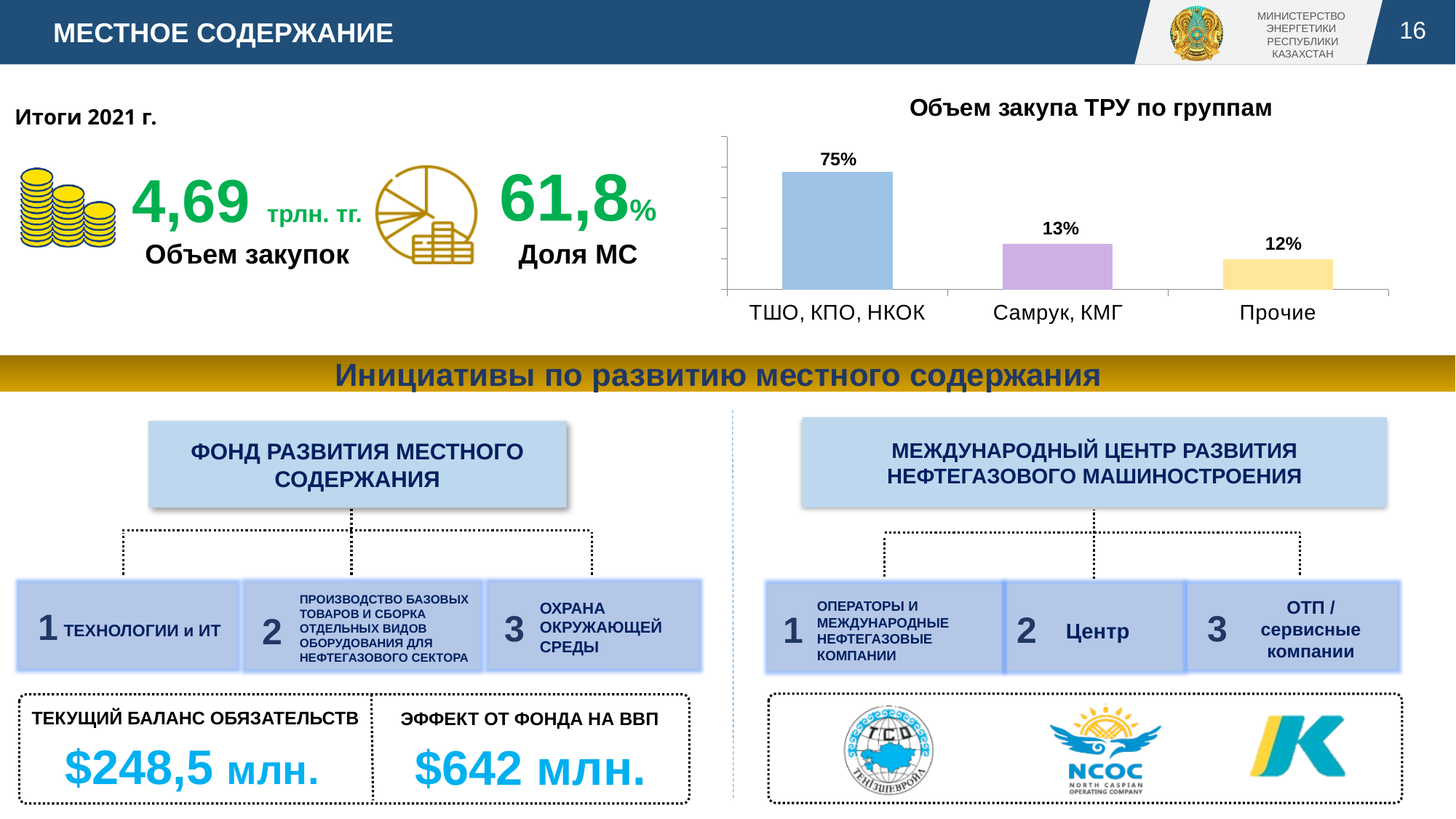
What is the title of the chart on the slide? Объем закупа ТРУ по группам What is the value for Самрук, КМГ in the chart 'Объем закупа ТРУ по группам'? 13% What is the difference between the values for Самрук, КМГ and Прочие in the chart 'Объем закупа ТРУ по группам'? 1% What is the value for Прочие in the chart 'Объем закупа ТРУ по группам'? 12% Do the values in the chart 'Объем закупа ТРУ по группам' rise or fall from left to right? Fall In the chart 'Объем закупа ТРУ по группам', which is larger: the value for ТШО, КПО, НКОК or the value for Прочие? ТШО, КПО, НКОК Which category has the highest value in the chart 'Объем закупа ТРУ по группам'? ТШО, КПО, НКОК What kind of chart is 'Объем закупа ТРУ по группам'? Bar chart What is the value for ТШО, КПО, НКОК in the chart 'Объем закупа ТРУ по группам'? 75% Which category has the lowest value in the chart 'Объем закупа ТРУ по группам'? Прочие How many categories are shown in the chart 'Объем закупа ТРУ по группам'? 3 What is the difference between the values for ТШО, КПО, НКОК and Самрук, КМГ in the chart 'Объем закупа ТРУ по группам'? 62%